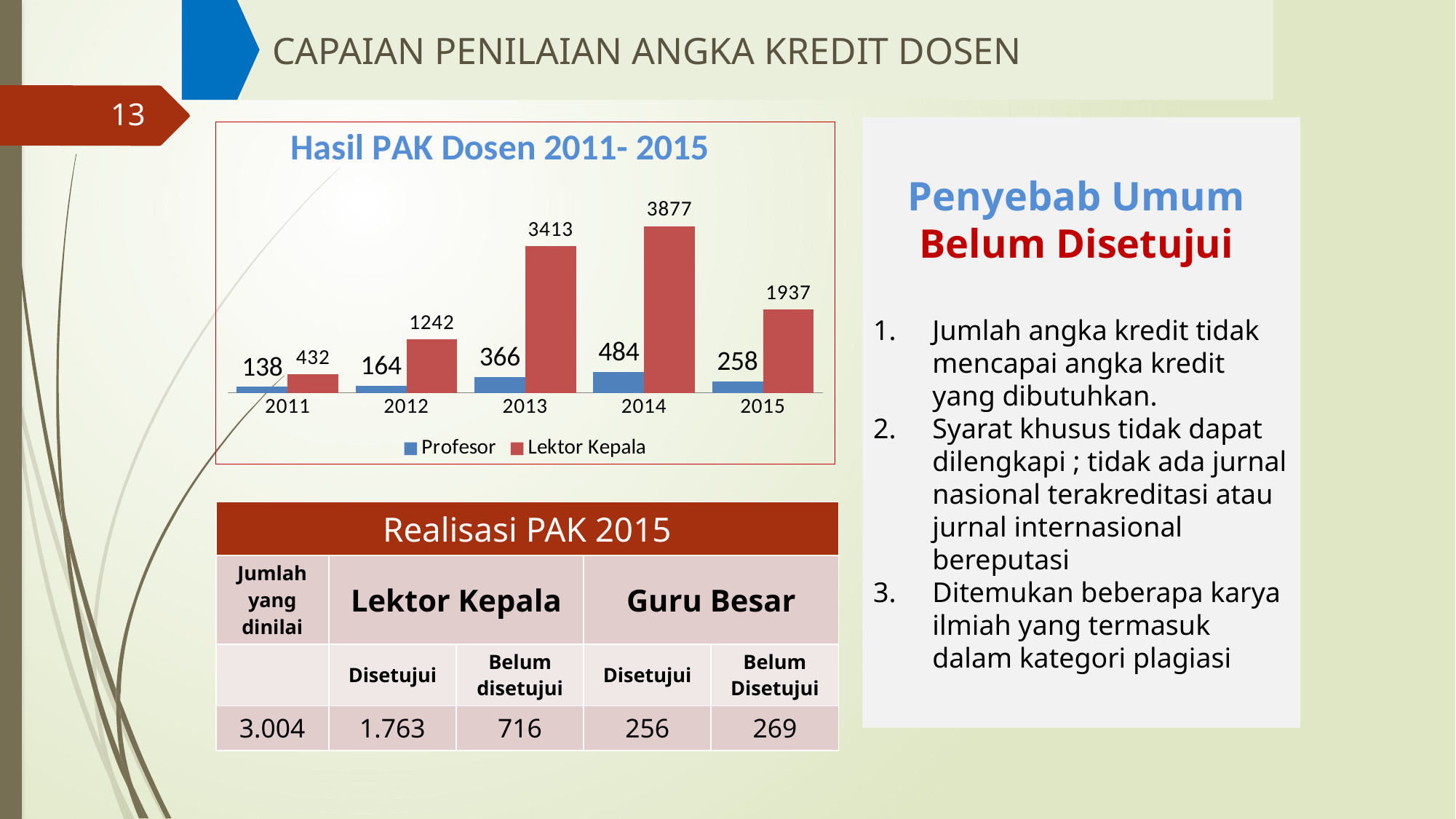
What is the value for Lektor Kepala in 2014? 3877 What is the title of the chart? Hasil PAK Dosen 2011- 2015 How many years are shown on the x axis of the chart? 5 Does the Lektor Kepala value rise or fall from 2014 to 2015? Fall How many series does the chart legend list? 2 What is the value for Profesor in 2013? 366 Which is larger, the Profesor value for 2015 or the Profesor value for 2012? 2015 What is the difference between the Lektor Kepala values for 2013 and 2012? 2171 What is the value for Lektor Kepala in 2011? 432 Which year has the lowest value for Lektor Kepala? 2011 Which year has the highest value for Profesor? 2014 What kind of chart is shown on the slide? Bar chart